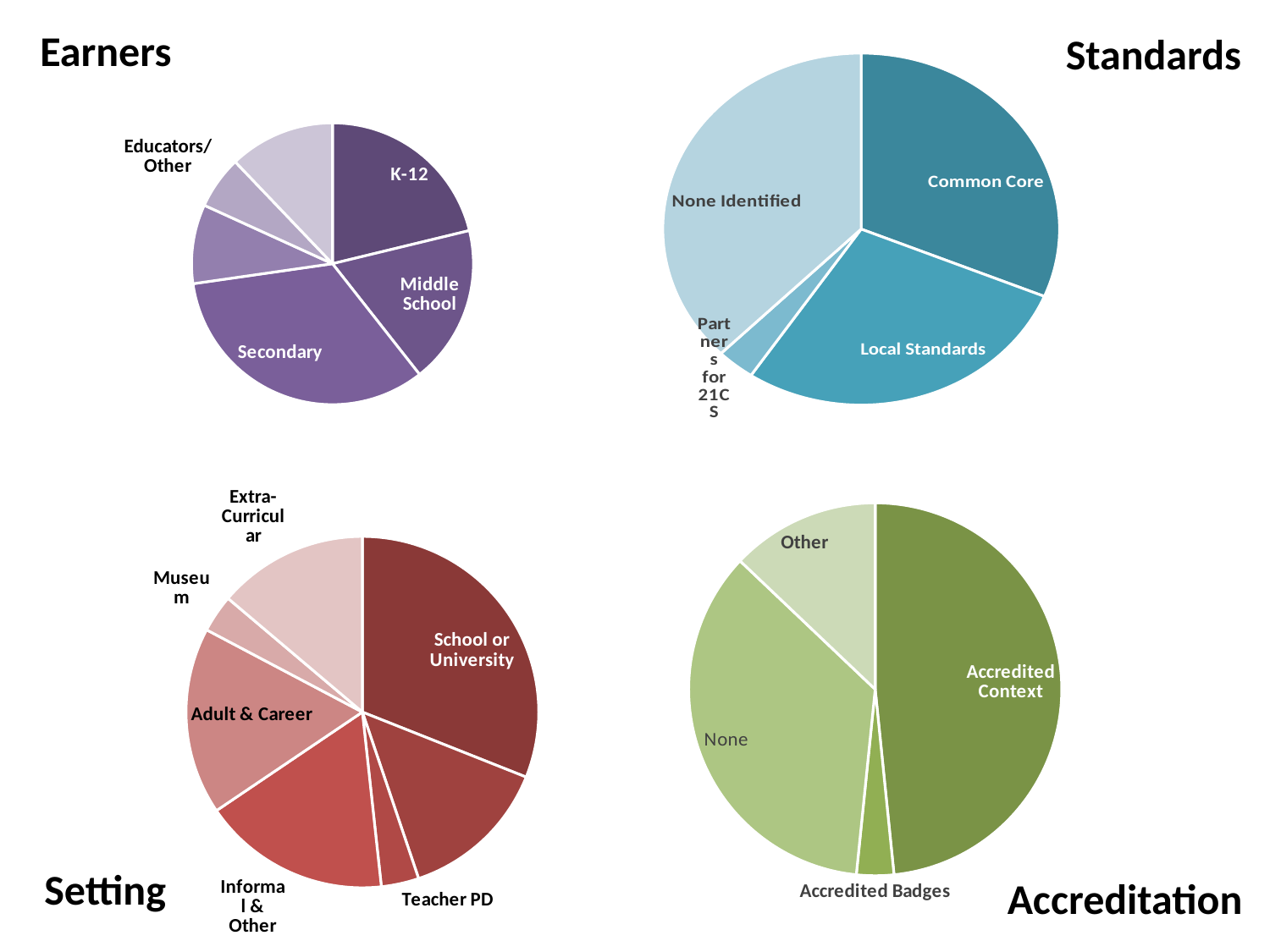
In the Accreditation chart, which slice is larger, None or Other? None In the Earners chart, which slice is larger, K-12 or Secondary? Secondary In the Accreditation chart, which category has the largest slice? Accredited Context In the Standards chart, which category has the smallest slice? Partners for 21CS How many slices does the Standards pie chart have? 4 How many pie charts are shown on the slide? 4 In the Setting chart, which category has the largest slice? School or University What kind of chart is the Earners chart? pie chart In the Standards chart, which category has the largest slice? None Identified In the Accreditation chart, which category has the smallest slice? Accredited Badges In the Setting chart, which slice is larger, Adult & Career or Museum? Adult & Career